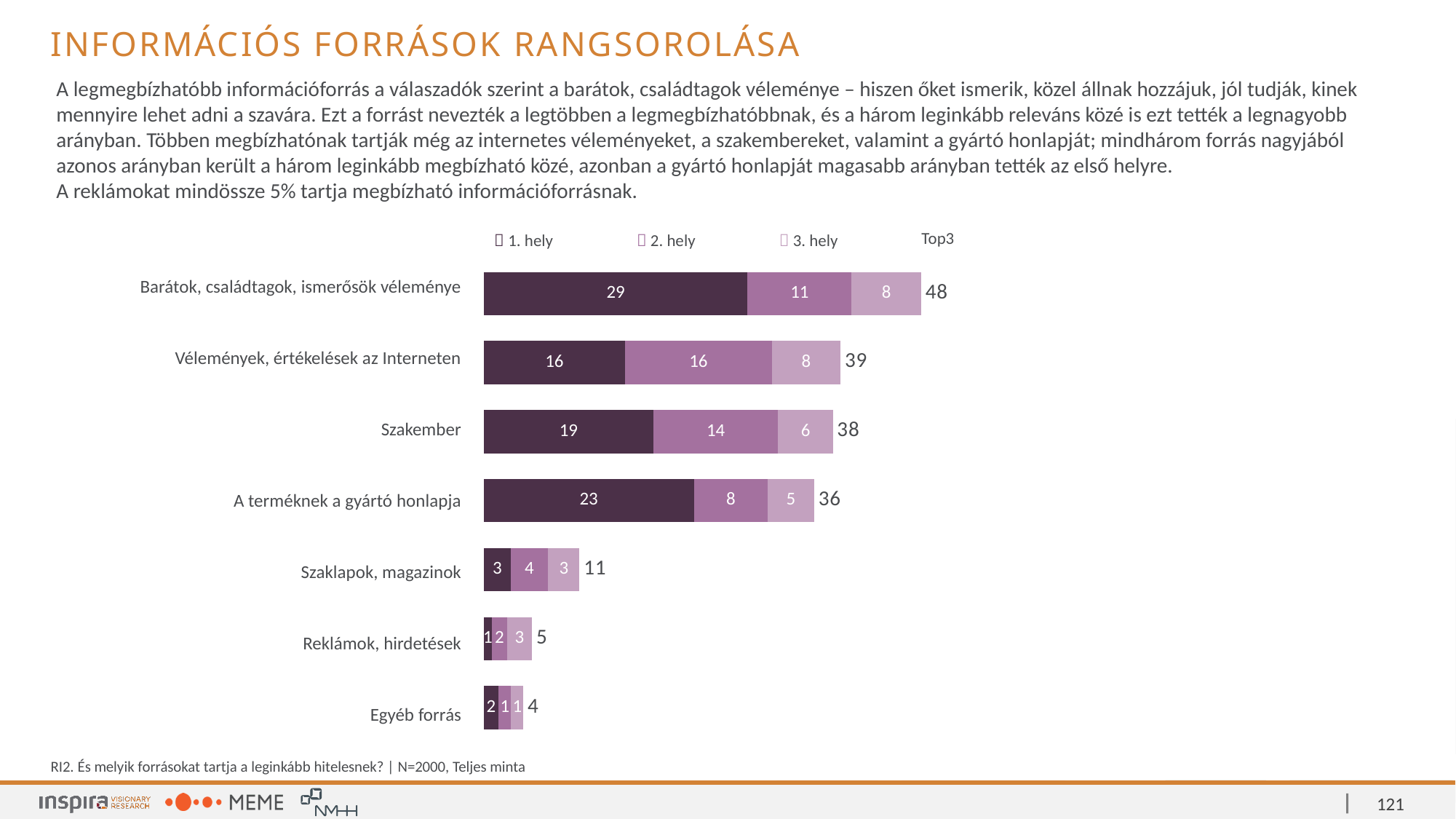
What is the '1. hely' value for 'Barátok, családtagok, ismerősök véleménye'? 29 What kind of chart is shown on the slide? Stacked bar chart How many series does the legend list? 3 What is the '2. hely' value for 'Szakember'? 14 How many categories are shown in the chart? 7 Which category has the highest Top3 total? Barátok, családtagok, ismerősök véleménye What is the Top3 total for 'Reklámok, hirdetések'? 5 What is the difference between the '1. hely' values for 'A terméknek a gyártó honlapja' and 'Szakember'? 4 What is the Top3 total for 'Vélemények, értékelések az Interneten'? 39 What is the '3. hely' value for 'A terméknek a gyártó honlapja'? 5 Which has a larger '1. hely' value: 'Vélemények, értékelések az Interneten' or 'Szakember'? Szakember Which category has the lowest Top3 total? Egyéb forrás